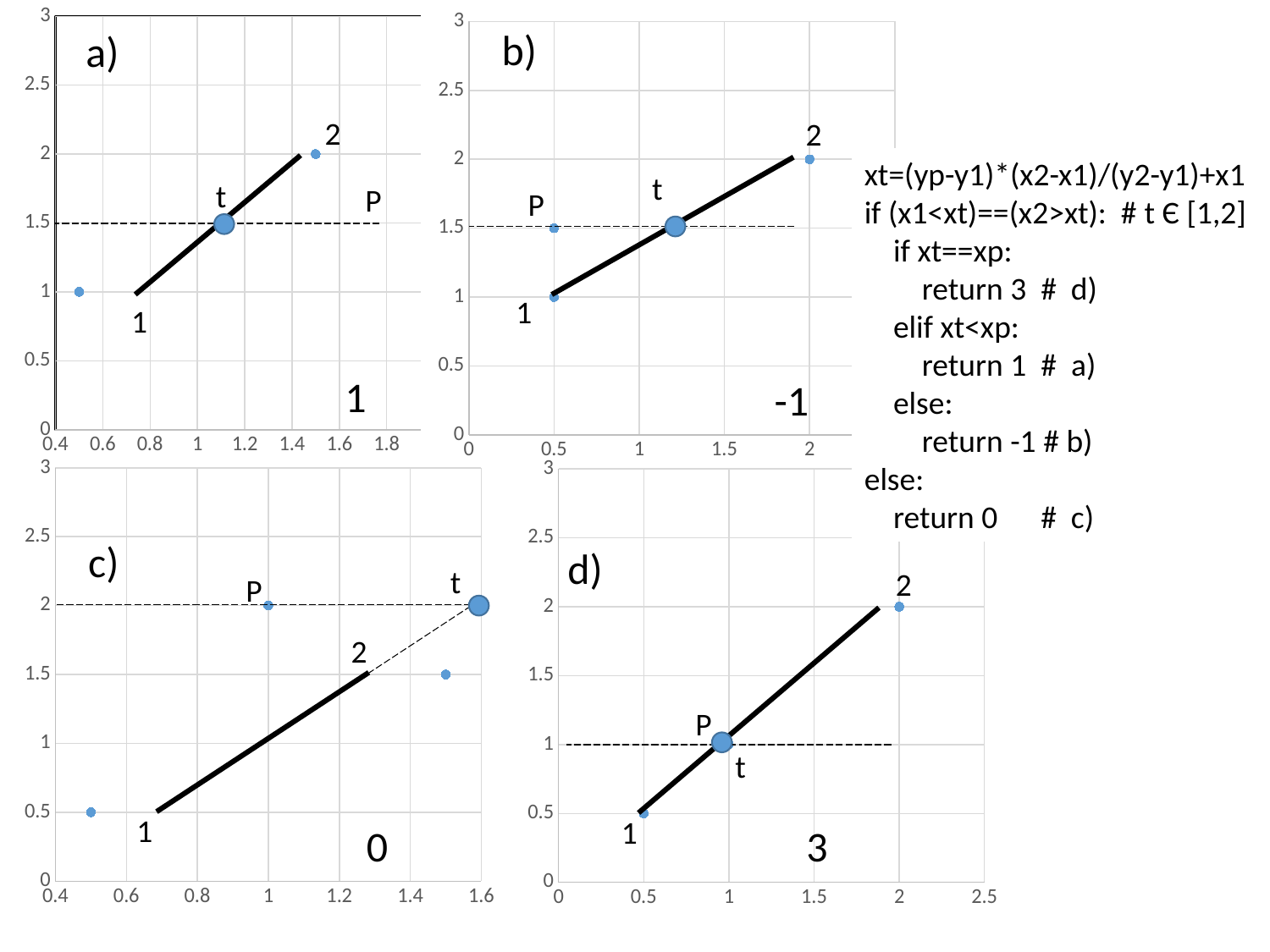
In chart b), what is the y value of point 2? 2 How many charts are shown on the slide? 4 What kind of chart is chart a)? scatter chart In chart b), what is the x value of point P? 0.5 In chart b), which point has the larger x value, P or t? t In chart c), which point has the larger y value, P or point 2? P In chart d), what is the y value of the dashed horizontal line through P? 1 What number is printed in the lower right of chart b)? -1 In chart b), is the x value of point t greater or less than 1? greater In chart c), what is the y value of the dashed horizontal line through P? 2 What is the maximum value shown on the y axis of chart a)? 3